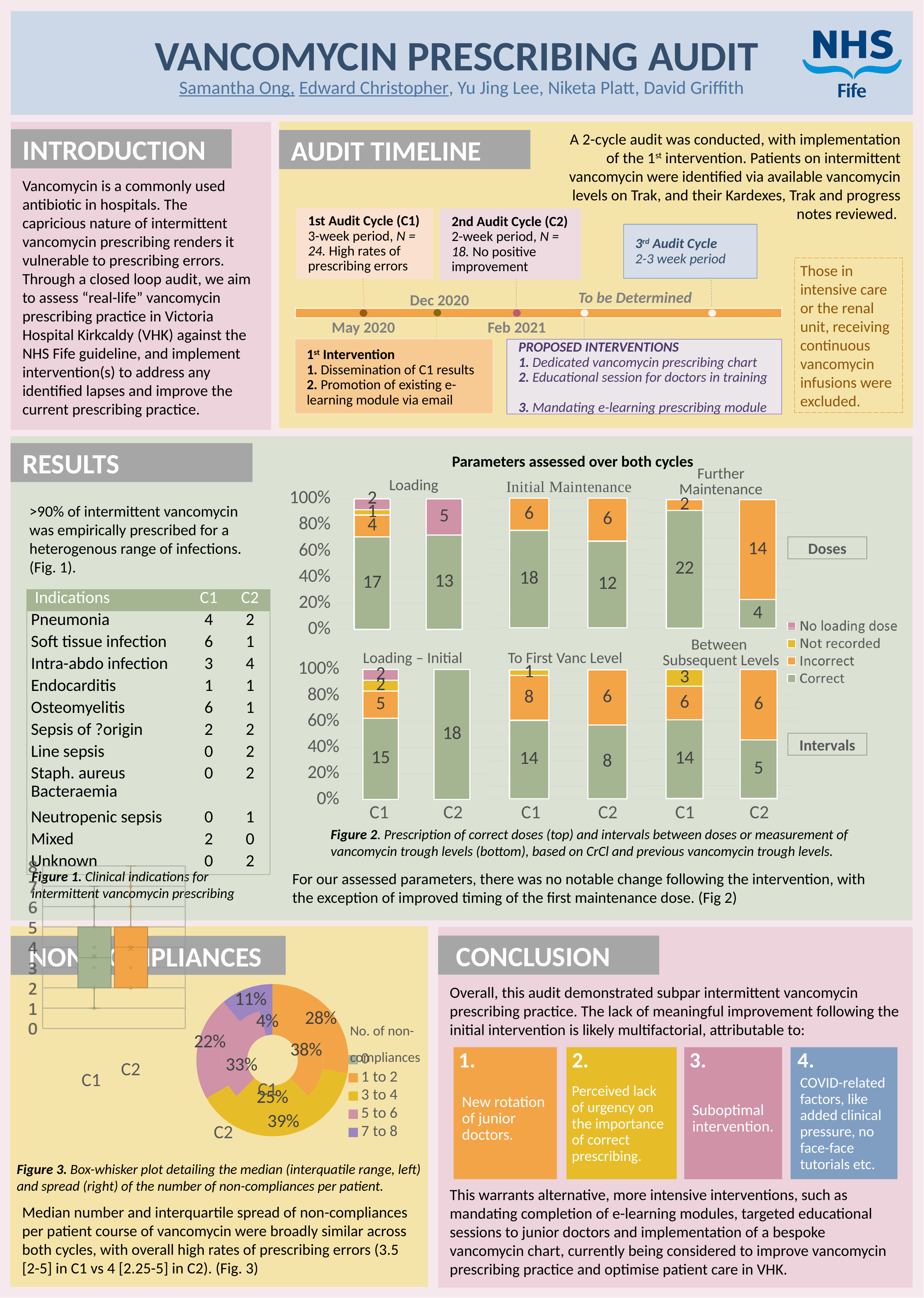
In Figure 2 (top, Doses), how many Correct loading doses were there in C1? 17 In Figure 2 (top, Doses), how many Incorrect Further Maintenance doses were there in C2? 14 In Figure 2 (top, Doses), what is the difference between Correct Further Maintenance doses in C1 and C2? 18 In Figure 2 (bottom, Intervals), how many Incorrect 'To First Vanc Level' intervals were there in C1? 8 In Figure 2 (bottom, Intervals), how many 'Not recorded' intervals were there for Between Subsequent Levels in C1? 3 How many series does the legend of Figure 2 list? 4 How many categories does the legend of the non-compliances donut chart (Figure 3, right) list? 5 In Figure 2 (bottom, Intervals), how many Correct Loading – Initial intervals were there in C2? 18 In Figure 2 (bottom, Intervals), which is larger for Between Subsequent Levels in C2: Correct or Incorrect? Incorrect In Figure 2 (top, Doses), what is the total number of Further Maintenance doses in C2 (Correct plus Incorrect)? 18 In Figure 2 (top, Doses), how many Correct Initial Maintenance doses were there in C2? 12 What kind of chart is Figure 2? Stacked bar chart